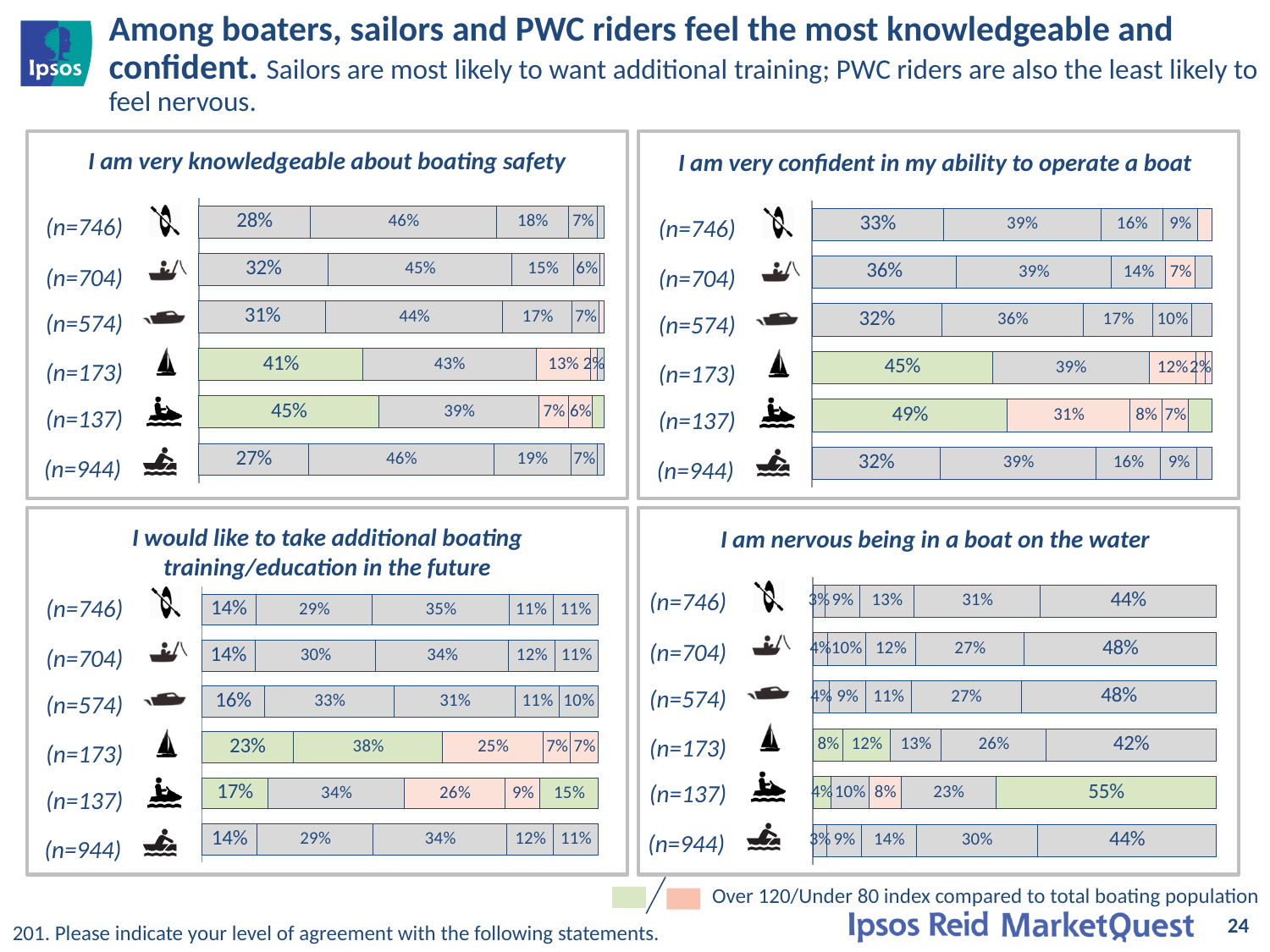
In the chart titled 'I would like to take additional boating training/education in the future', which row has the highest first (leftmost) segment value? (n=173) In the chart titled 'I am very confident in my ability to operate a boat', what is the first (leftmost) segment value for the (n=173) row? 45% How many rows (bars) are shown in the chart titled 'I am very knowledgeable about boating safety'? 6 In the chart titled 'I am nervous being in a boat on the water', what is the last (rightmost) segment value for the (n=137) row? 55% In the chart titled 'I am very confident in my ability to operate a boat', which row has the highest first (leftmost) segment value? (n=137) In the chart titled 'I would like to take additional boating training/education in the future', what is the last (rightmost) segment value for the (n=137) row? 15% In the chart titled 'I am very confident in my ability to operate a boat', is the first segment value for the (n=704) row larger or smaller than that for the (n=574) row? larger What type of chart is used for 'I am nervous being in a boat on the water'? Stacked bar chart In the chart titled 'I am very knowledgeable about boating safety', what is the first (leftmost) segment value for the (n=137) row? 45% How many charts are shown on the slide? 4 In the chart titled 'I am nervous being in a boat on the water', what is the difference between the rightmost segment values for the (n=137) row and the (n=173) row? 13% In the chart titled 'I am very knowledgeable about boating safety', which row has the lowest first (leftmost) segment value? (n=944)